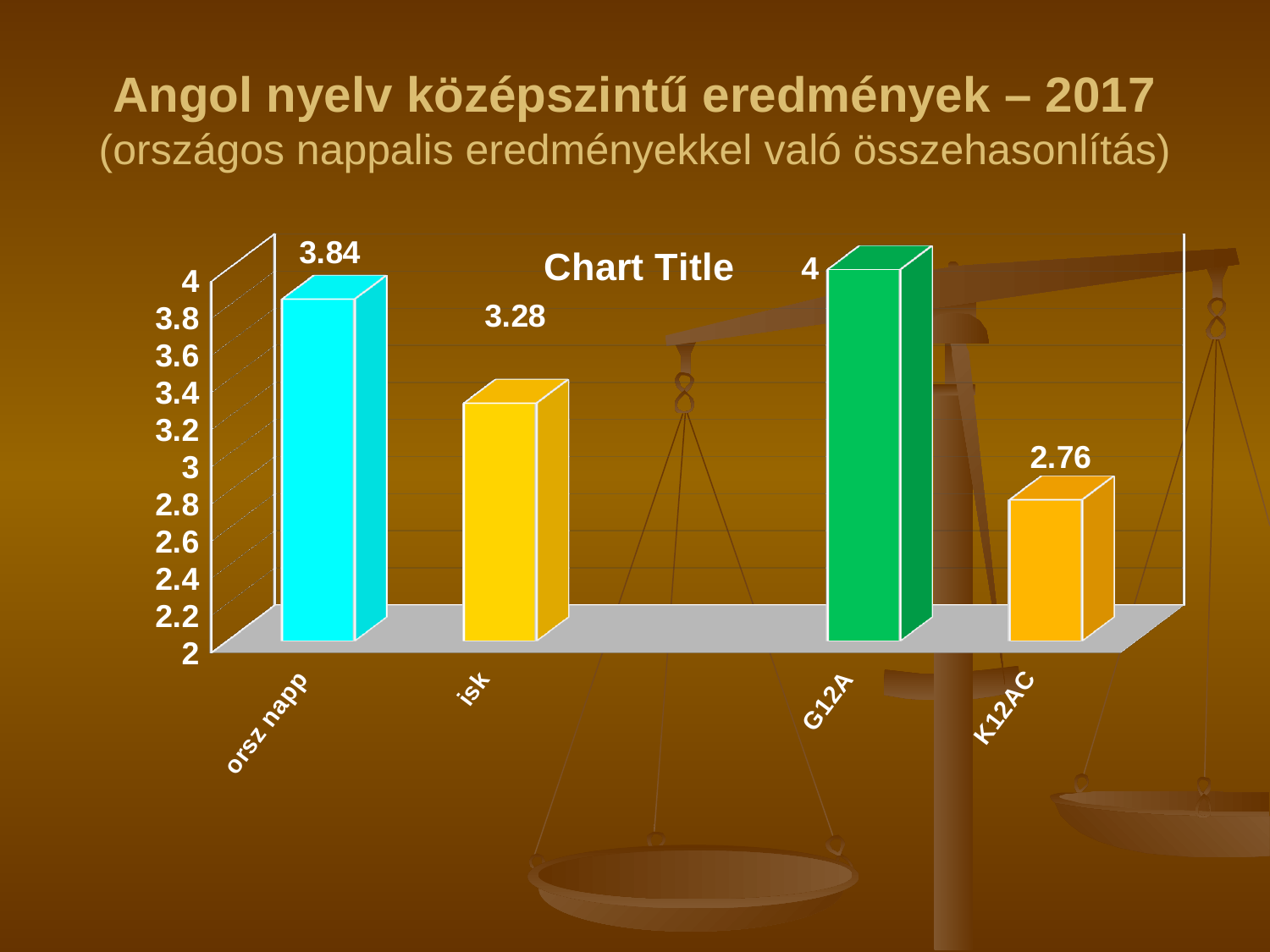
What is the value for orsz napp? 3.84 What is the title printed inside the chart area? Chart Title Which category has the highest value? G12A What is the difference between the values for G12A and K12AC? 1.24 Which category has the lowest value? K12AC How many categories are shown on the chart? 4 What is the value for G12A? 4 What is the value for K12AC? 2.76 What is the difference between the values for orsz napp and isk? 0.56 What is the value for isk? 3.28 Which is larger, the value for isk or the value for K12AC? isk What kind of chart is shown on the slide? bar chart